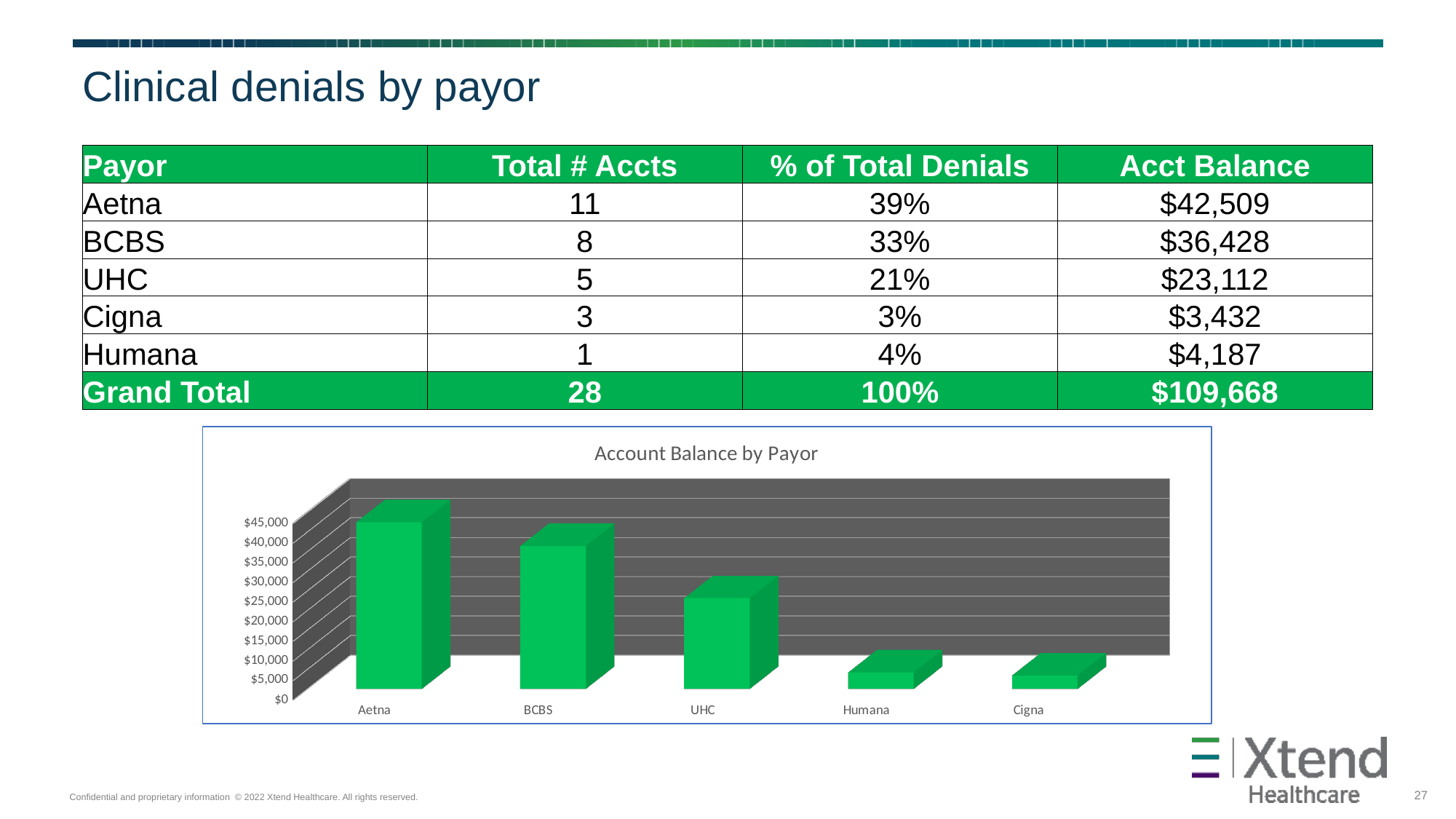
In the "Account Balance by Payor" chart, is the bar for Humana greater or less than $10,000? less In the "Account Balance by Payor" chart, which is larger, the bar for BCBS or the bar for UHC? BCBS What is the title of the chart on the slide? Account Balance by Payor According to the table on the slide, what is the account balance for UHC? $23,112 In the "Account Balance by Payor" chart, is the bar for Aetna greater or less than $40,000? greater How many payors are plotted in the "Account Balance by Payor" chart? 5 In the "Account Balance by Payor" chart, is the bar for UHC greater or less than $30,000? less In the "Account Balance by Payor" chart, which payor has the highest account balance? Aetna What type of chart is shown under the title "Account Balance by Payor"? bar chart In the "Account Balance by Payor" chart, do the bars generally rise or fall from left to right? fall According to the table on the slide, what is the difference between the account balances of Aetna and BCBS? $6,081